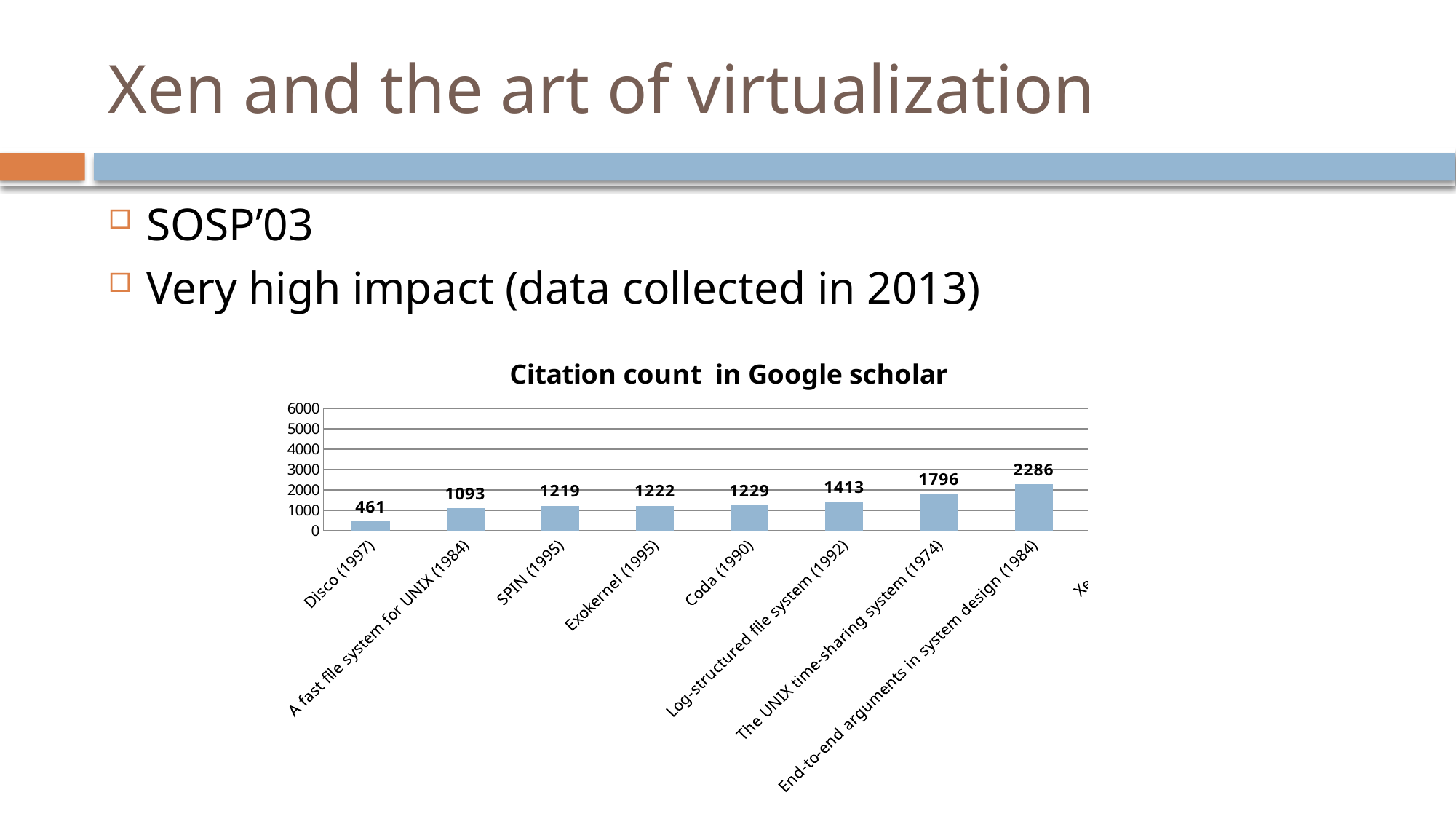
What is the citation count for Log-structured file system (1992)? 1413 What kind of chart is shown on the slide? bar chart Among the bars shown, which paper has the lowest citation count? Disco (1997) Is the citation count for Disco (1997) greater or less than 1000? less What is the title of the chart? Citation count in Google scholar What is the citation count for SPIN (1995)? 1219 Which has a higher citation count, Disco (1997) or SPIN (1995)? SPIN (1995) What is the citation count for The UNIX time-sharing system (1974)? 1796 What is the difference in citation count between End-to-end arguments in system design (1984) and The UNIX time-sharing system (1974)? 490 What is the difference in citation count between Log-structured file system (1992) and Disco (1997)? 952 What is the citation count for Disco (1997)? 461 What is the citation count for End-to-end arguments in system design (1984)? 2286